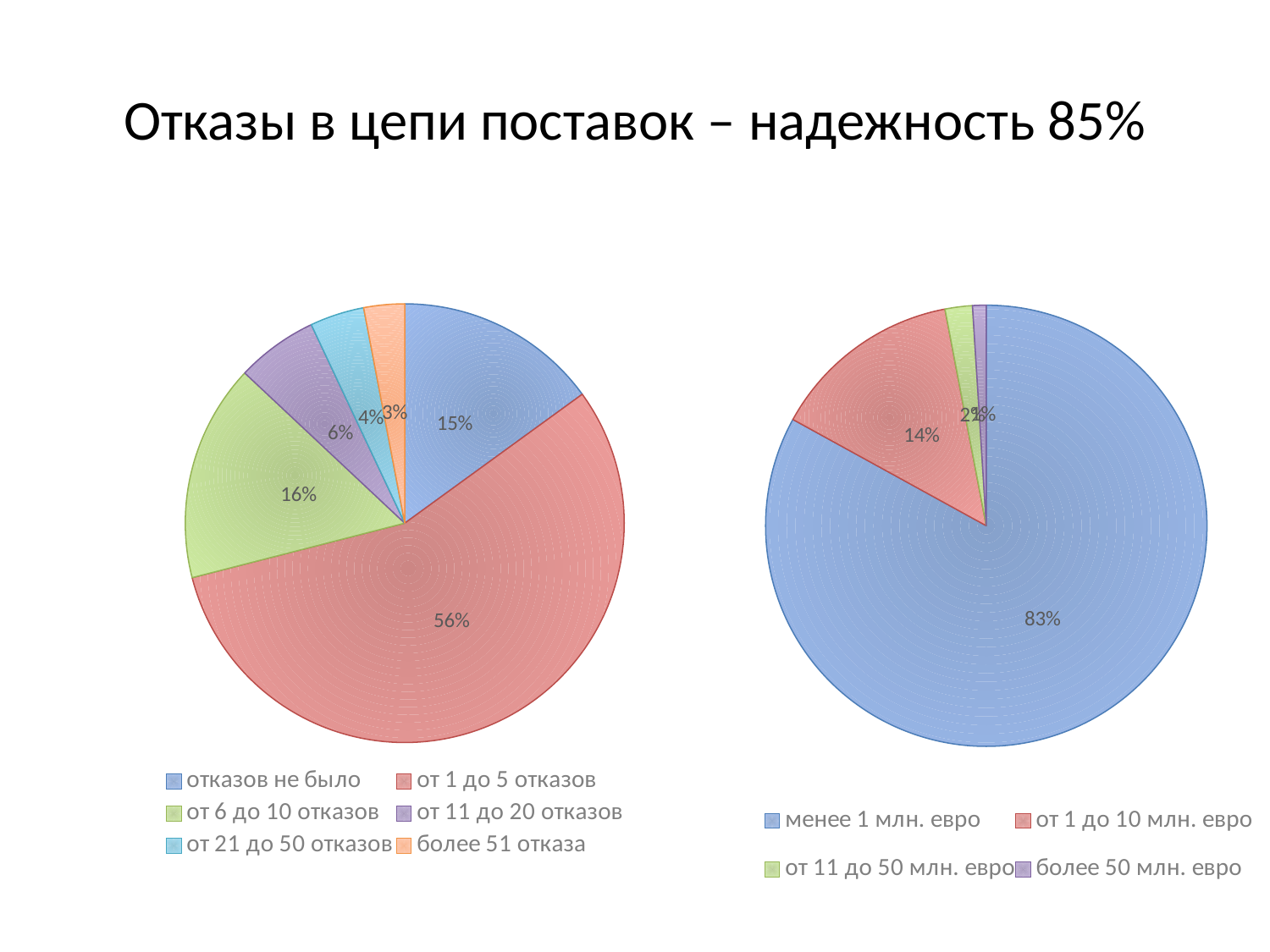
On the left pie chart, which category has the smallest slice? более 51 отказа On the left pie chart, what is the difference between the shares for 'от 1 до 5 отказов' and 'от 6 до 10 отказов'? 40% What type of chart is shown on the right side of the slide? Pie chart On the left pie chart, what share is shown for 'от 6 до 10 отказов'? 16% On the left pie chart, what share is shown for 'отказов не было'? 15% On the right pie chart, which category has the largest slice? менее 1 млн. евро On the right pie chart, what share is shown for 'менее 1 млн. евро'? 83% How many categories does the legend of the left pie chart list? 6 On the left pie chart, what share is shown for 'от 11 до 20 отказов'? 6% On the left pie chart, what share is shown for 'от 1 до 5 отказов'? 56% On the right pie chart, what share is shown for 'от 1 до 10 млн. евро'? 14% On the left pie chart, which category has the largest slice? от 1 до 5 отказов